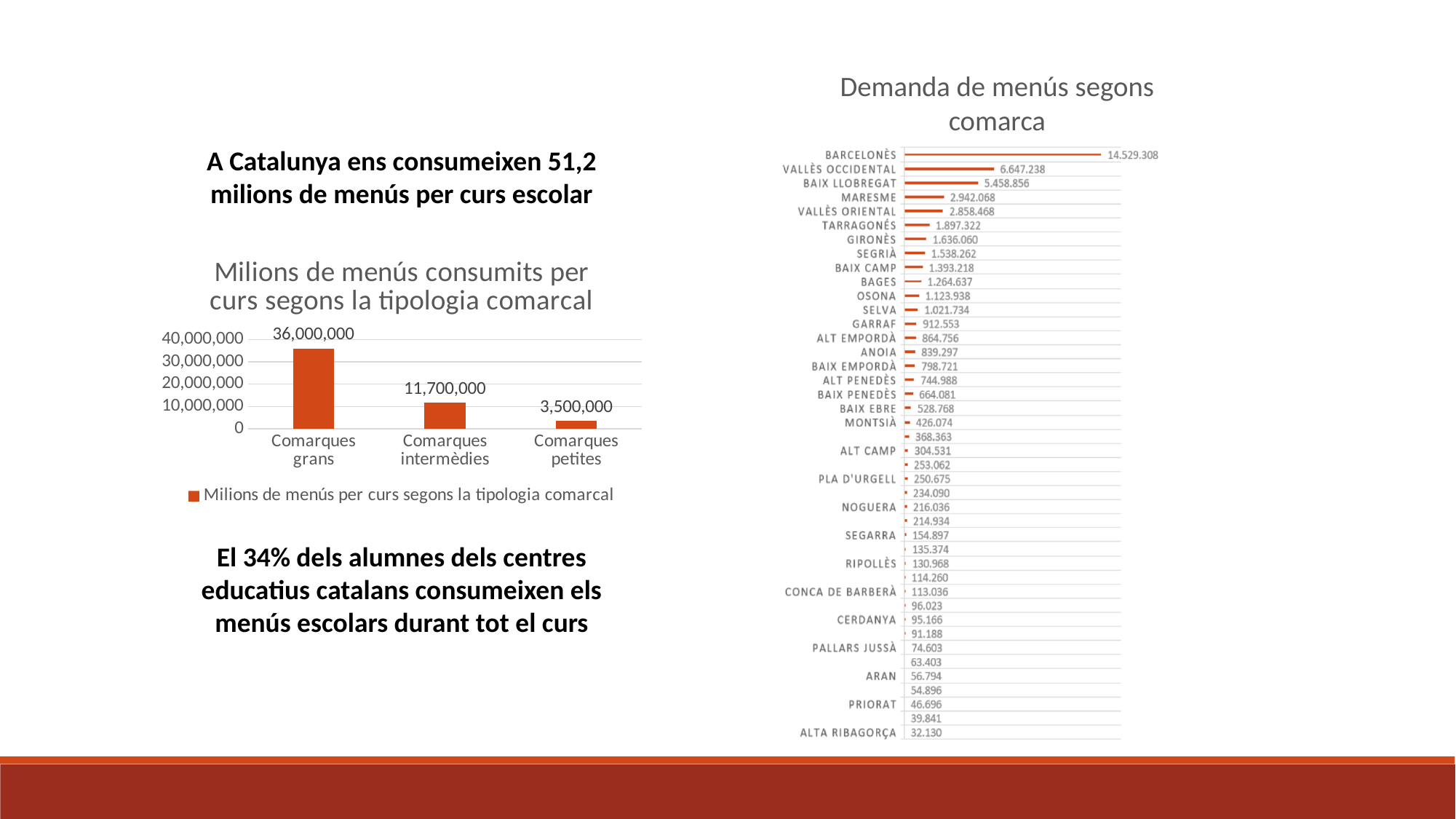
In the chart 'Milions de menús consumits per curs segons la tipologia comarcal', do the values rise or fall from left to right? Fall In the chart 'Demanda de menús segons comarca', which is larger, Maresme or Tarragonès? Maresme In the chart 'Milions de menús consumits per curs segons la tipologia comarcal', what kind of chart is it? Bar chart In the chart 'Demanda de menús segons comarca', what is the value for Gironès? 1.636.060 In the chart 'Demanda de menús segons comarca', which comarca has the highest value? Barcelonès In the chart 'Milions de menús consumits per curs segons la tipologia comarcal', which category has the lowest value? Comarques petites In the chart 'Milions de menús consumits per curs segons la tipologia comarcal', what is the value for Comarques grans? 36,000,000 In the chart 'Milions de menús consumits per curs segons la tipologia comarcal', how many categories are shown? 3 In the chart 'Milions de menús consumits per curs segons la tipologia comarcal', what is the value for Comarques petites? 3,500,000 In the chart 'Demanda de menús segons comarca', what is the value for Barcelonès? 14.529.308 In the chart 'Milions de menús consumits per curs segons la tipologia comarcal', what is the difference between Comarques grans and Comarques intermèdies? 24,300,000 In the chart 'Demanda de menús segons comarca', what is the difference between Barcelonès and Vallès Occidental? 7.882.070